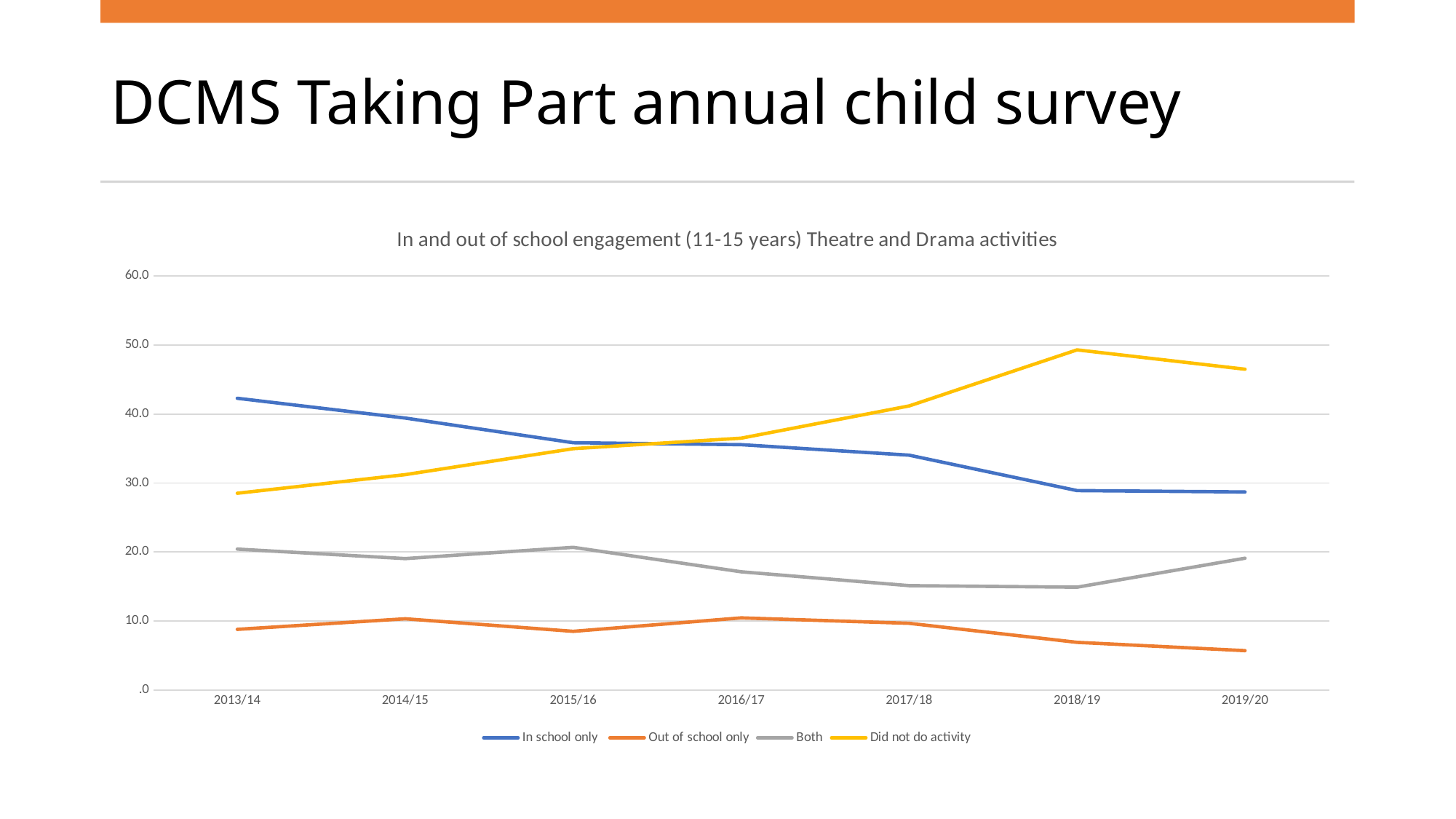
What is the title of the chart? In and out of school engagement (11-15 years) Theatre and Drama activities Is the value for 'In school only' in 2013/14 greater or less than 40? greater Is the value for 'Did not do activity' in 2018/19 greater or less than 40? greater Which series has the highest value in 2013/14? In school only Does the 'In school only' line rise or fall from 2013/14 to 2019/20? Fall How many series does the legend list? 4 What kind of chart is shown on the slide? Line chart How many survey years are shown along the x axis? 7 In 2017/18, which is larger: 'Did not do activity' or 'In school only'? Did not do activity Which series has the highest value in 2019/20? Did not do activity Which series has the lowest value in 2013/14? Out of school only Is the value for 'Out of school only' in 2019/20 greater or less than 10? less